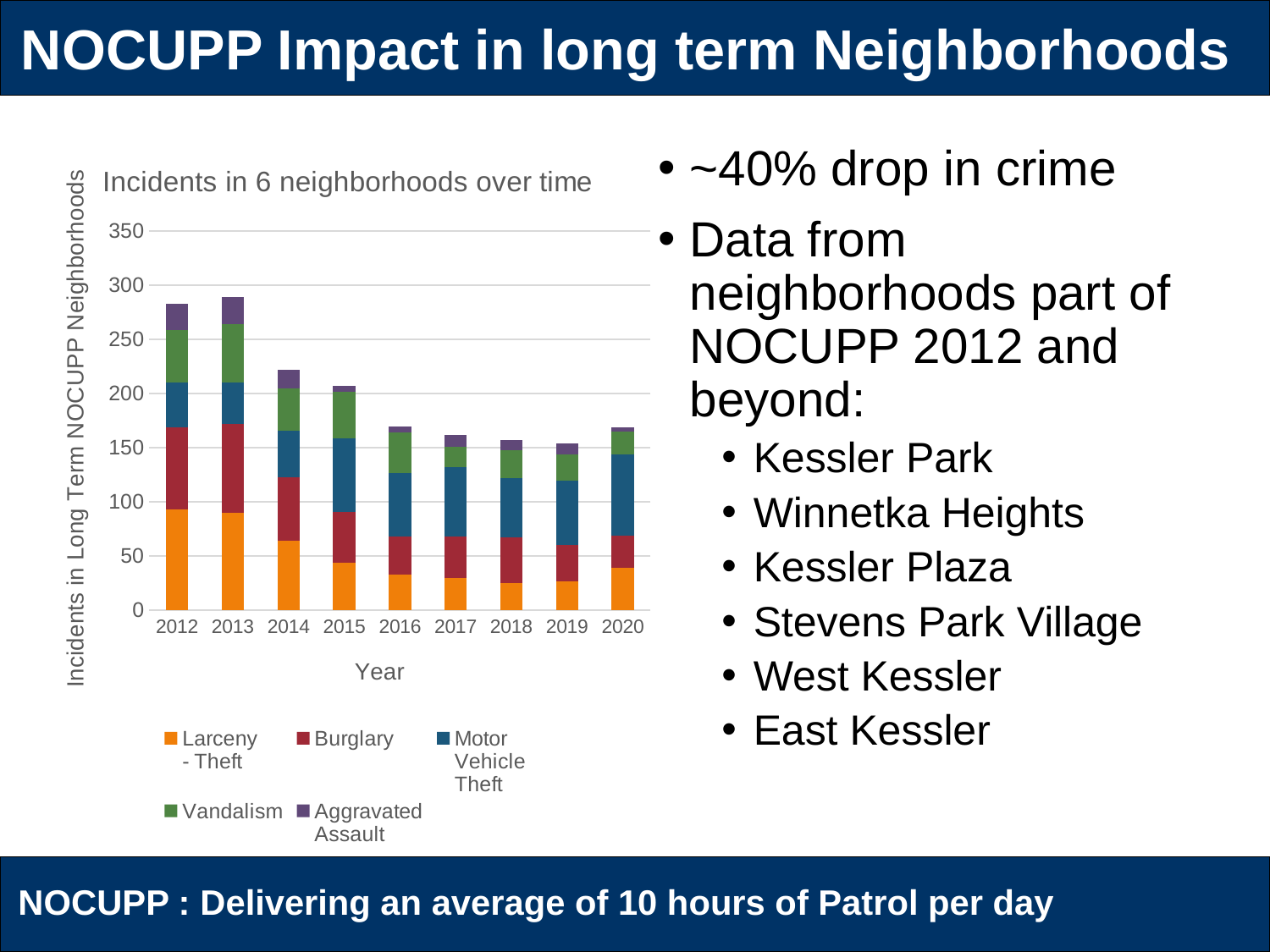
Is the total number of incidents in 2012 greater or less than 250? greater Is the total number of incidents in 2014 greater or less than 200? greater Which year has the larger total number of incidents, 2012 or 2020? 2012 Do the total incidents generally rise or fall from 2012 to 2020? fall What kind of chart is shown on the slide? Stacked bar chart How many years are shown on the x axis of the chart? 9 Is the total number of incidents in 2016 greater or less than 200? less What is the label on the x axis of the chart? Year How many series does the chart's legend list? 5 What is the title of the chart? Incidents in 6 neighborhoods over time